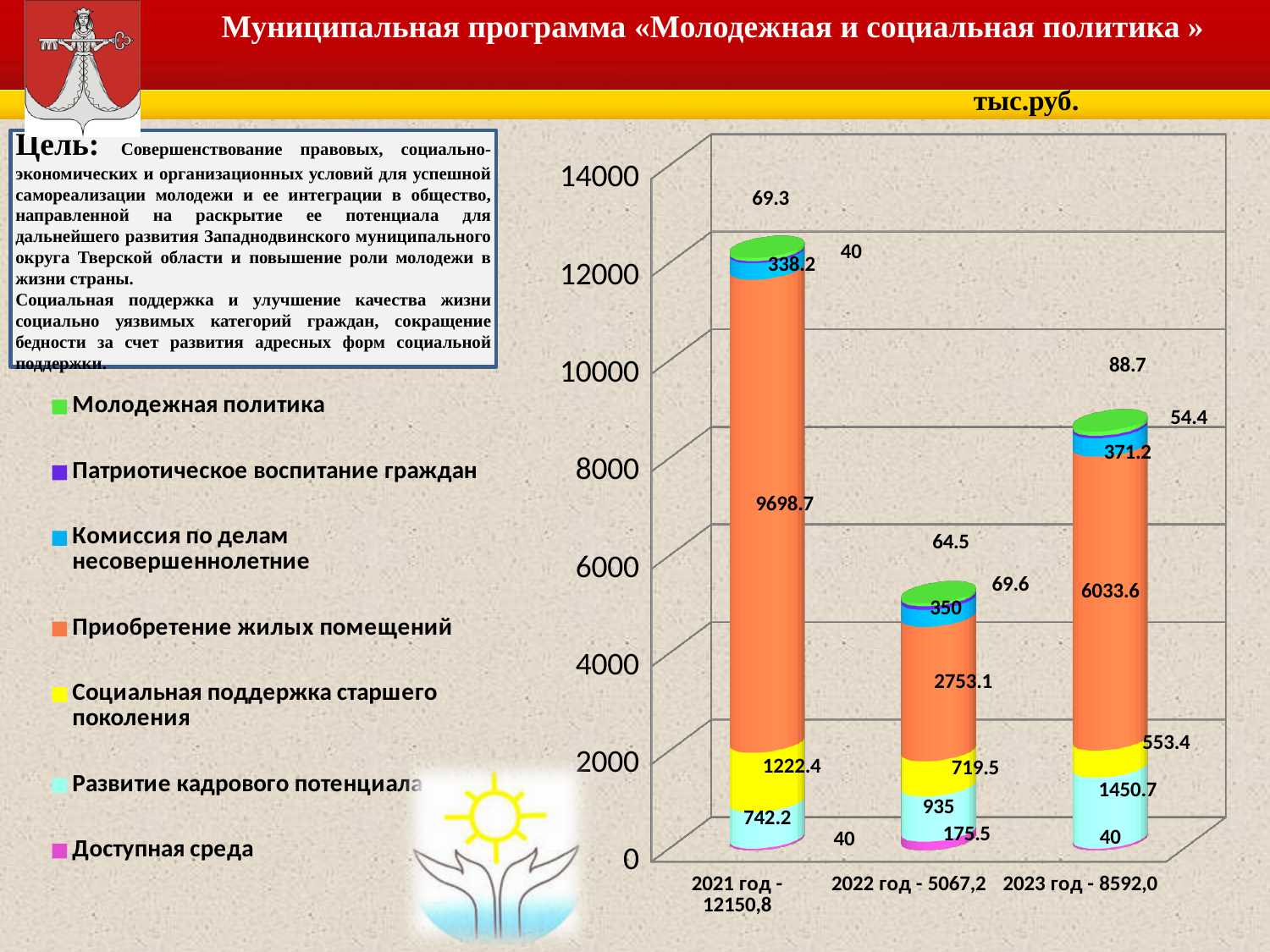
How many series does the legend list? 7 What is the total of the stacked bar for 2021? 12150,8 How many years (categories) are shown on the x axis? 3 What is the value for Приобретение жилых помещений in 2021? 9698.7 Which year has the lowest total stacked bar? 2022 Which year has the larger value for Комиссия по делам несовершеннолетние, 2022 or 2023? 2023 What kind of chart is shown on the slide? stacked bar chart Is the total height of the 2023 stacked bar greater or less than 8000? greater What is the value for Развитие кадрового потенциала in 2023? 1450.7 In which year is the value for Приобретение жилых помещений the highest? 2021 What is the value for Доступная среда in 2022? 175.5 What is the difference between the values for Социальная поддержка старшего поколения in 2021 and 2022? 502.9